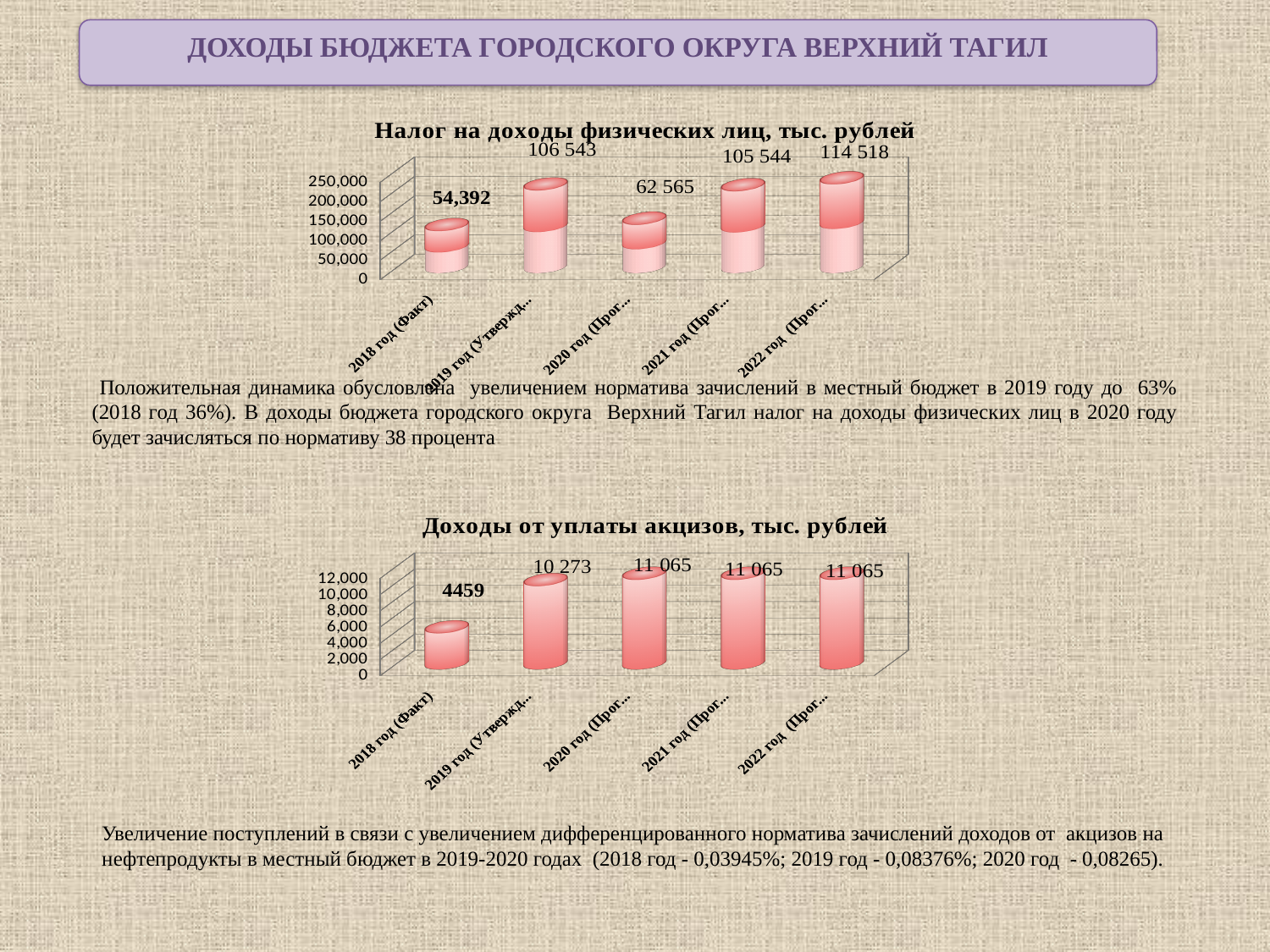
In the chart 'Налог на доходы физических лиц, тыс. рублей', which year has the lowest value? 2018 год (Факт) In the chart 'Налог на доходы физических лиц, тыс. рублей', what is the difference between the 2019 value and the 2020 value? 43 978 In the chart 'Налог на доходы физических лиц, тыс. рублей', which year has the highest value? 2022 год In the chart 'Налог на доходы физических лиц, тыс. рублей', what is the value for 2018 год (Факт)? 54,392 In the chart 'Налог на доходы физических лиц, тыс. рублей', which is larger: the value for 2019 год or the value for 2021 год? 2019 год What type of chart is the bottom chart 'Доходы от уплаты акцизов, тыс. рублей'? Bar chart In the chart 'Доходы от уплаты акцизов, тыс. рублей', what is the value for 2018 год (Факт)? 4459 How many categories are shown in the chart 'Налог на доходы физических лиц, тыс. рублей'? 5 In the chart 'Налог на доходы физических лиц, тыс. рублей', what is the value for 2020 год? 62 565 In the chart 'Доходы от уплаты акцизов, тыс. рублей', what is the value for 2019 год? 10 273 In the chart 'Доходы от уплаты акцизов, тыс. рублей', what is the difference between the 2020 value and the 2018 value? 6606 In the chart 'Доходы от уплаты акцизов, тыс. рублей', which year has the lowest value? 2018 год (Факт)